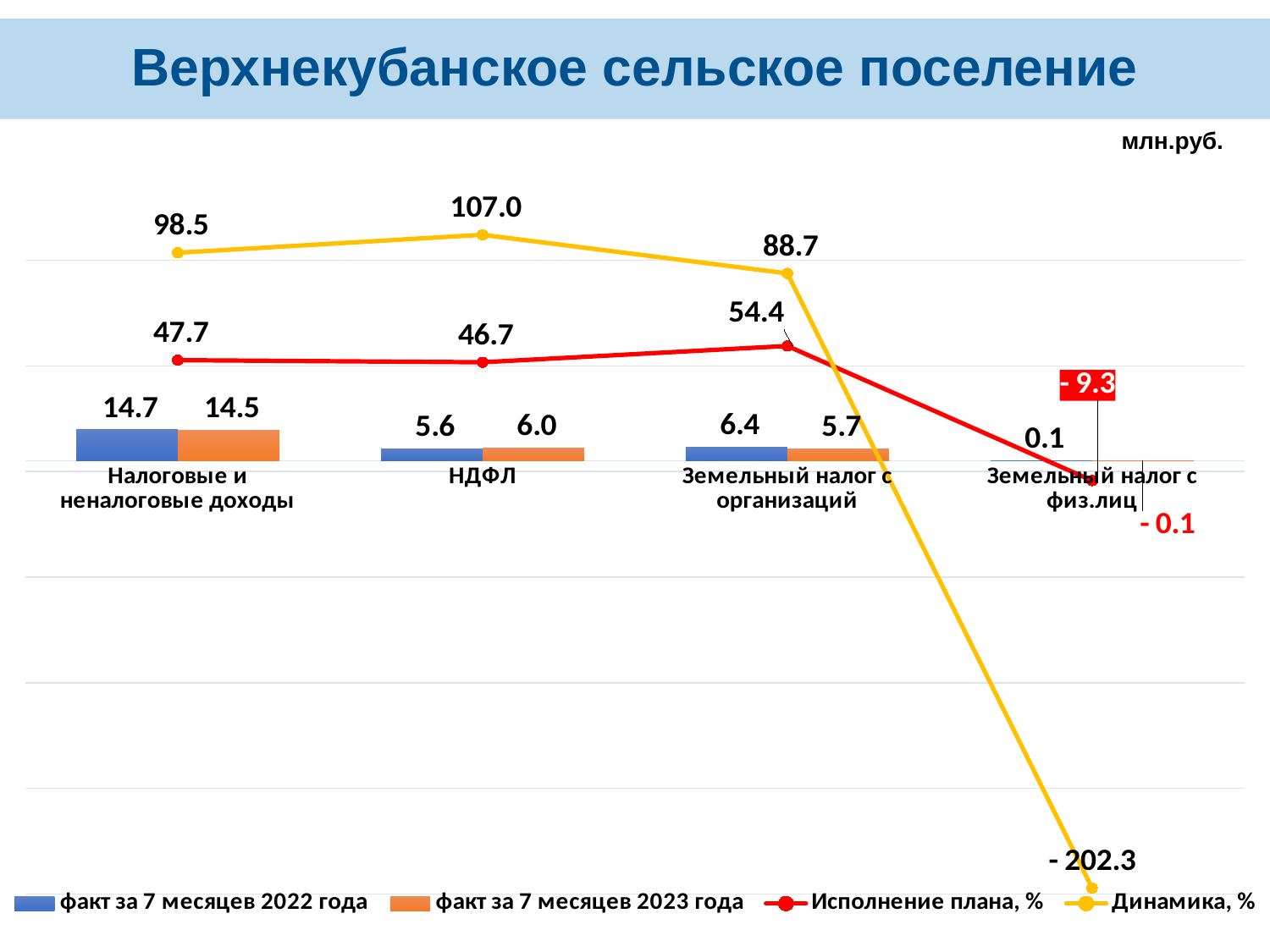
For 'Земельный налог с организаций', which is larger: 'факт за 7 месяцев 2022 года' or 'факт за 7 месяцев 2023 года'? факт за 7 месяцев 2022 года What unit is indicated in the top right corner of the chart? млн.руб. Which category has the lowest 'Исполнение плана, %' value? Земельный налог с физ.лиц What is the 'Динамика, %' value for 'Земельный налог с физ.лиц'? - 202.3 What is the value of 'факт за 7 месяцев 2022 года' for 'Налоговые и неналоговые доходы'? 14.7 What is the 'Исполнение плана, %' value for 'Земельный налог с организаций'? 54.4 How many categories are shown on the x axis? 4 Which category has the highest 'Динамика, %' value? НДФЛ What kind of chart is shown on the slide? Combined bar and line chart What is the value of 'факт за 7 месяцев 2023 года' for 'НДФЛ'? 6.0 What is the difference between 'Динамика, %' for 'НДФЛ' and for 'Налоговые и неналоговые доходы'? 8.5 How many series does the legend list? 4